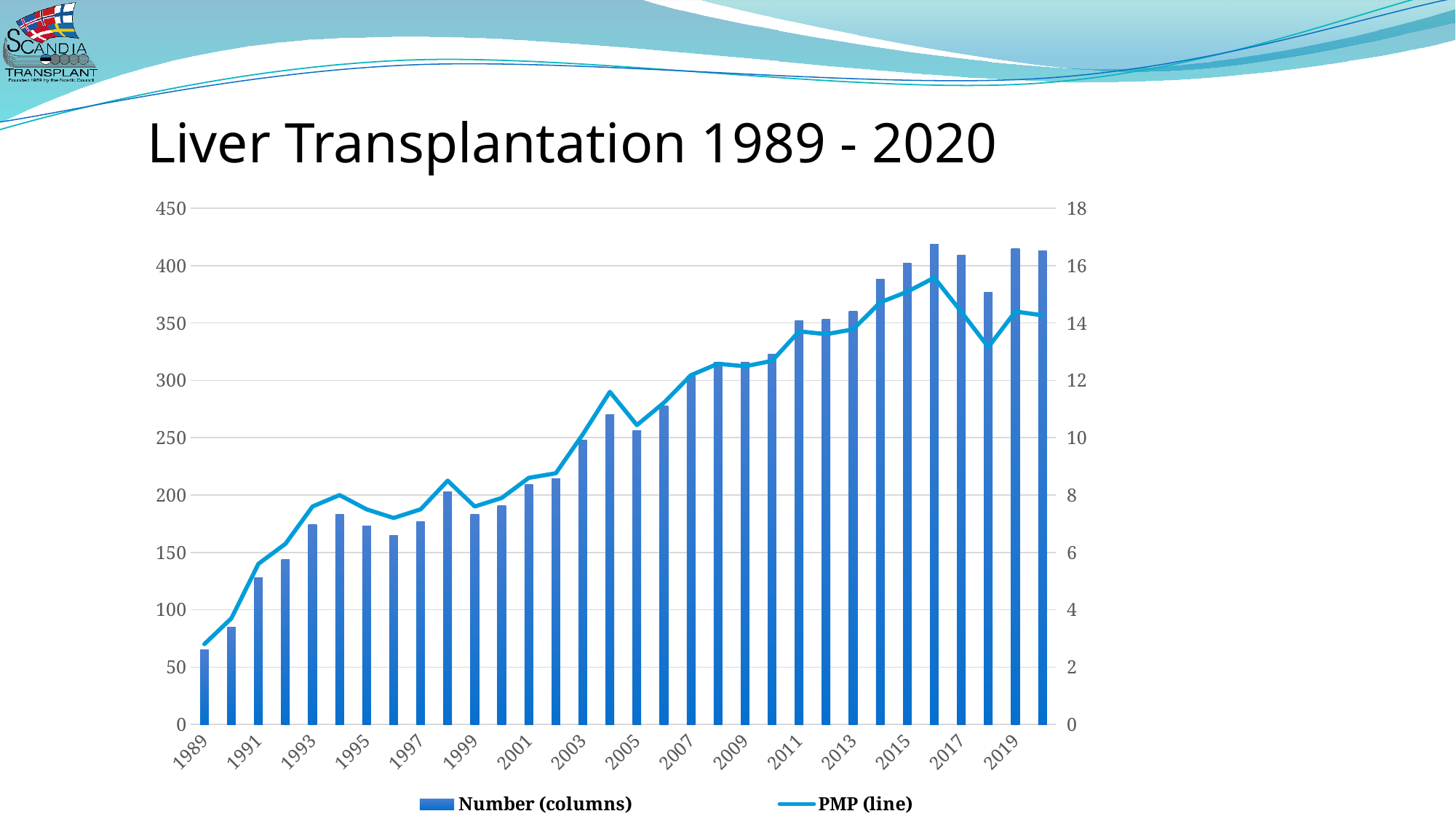
Is the PMP value for 2018 greater or less than 14? less Which year has the higher number of liver transplantations, 2017 or 2018? 2017 Which year has the lowest number of liver transplantations (shortest bar)? 1989 Is the number of liver transplantations in 1989 greater or less than 100? less In which year does the PMP line reach its highest point? 2016 How many years (bars) are plotted on the chart? 32 Is the number of liver transplantations in 2018 greater or less than 400? less What are the two series named in the legend? Number (columns) and PMP (line) Overall, does the number of liver transplantations rise or fall from 1989 to 2020? rise How many series does the legend list? 2 What kind of chart is shown on the slide? A combined bar and line chart